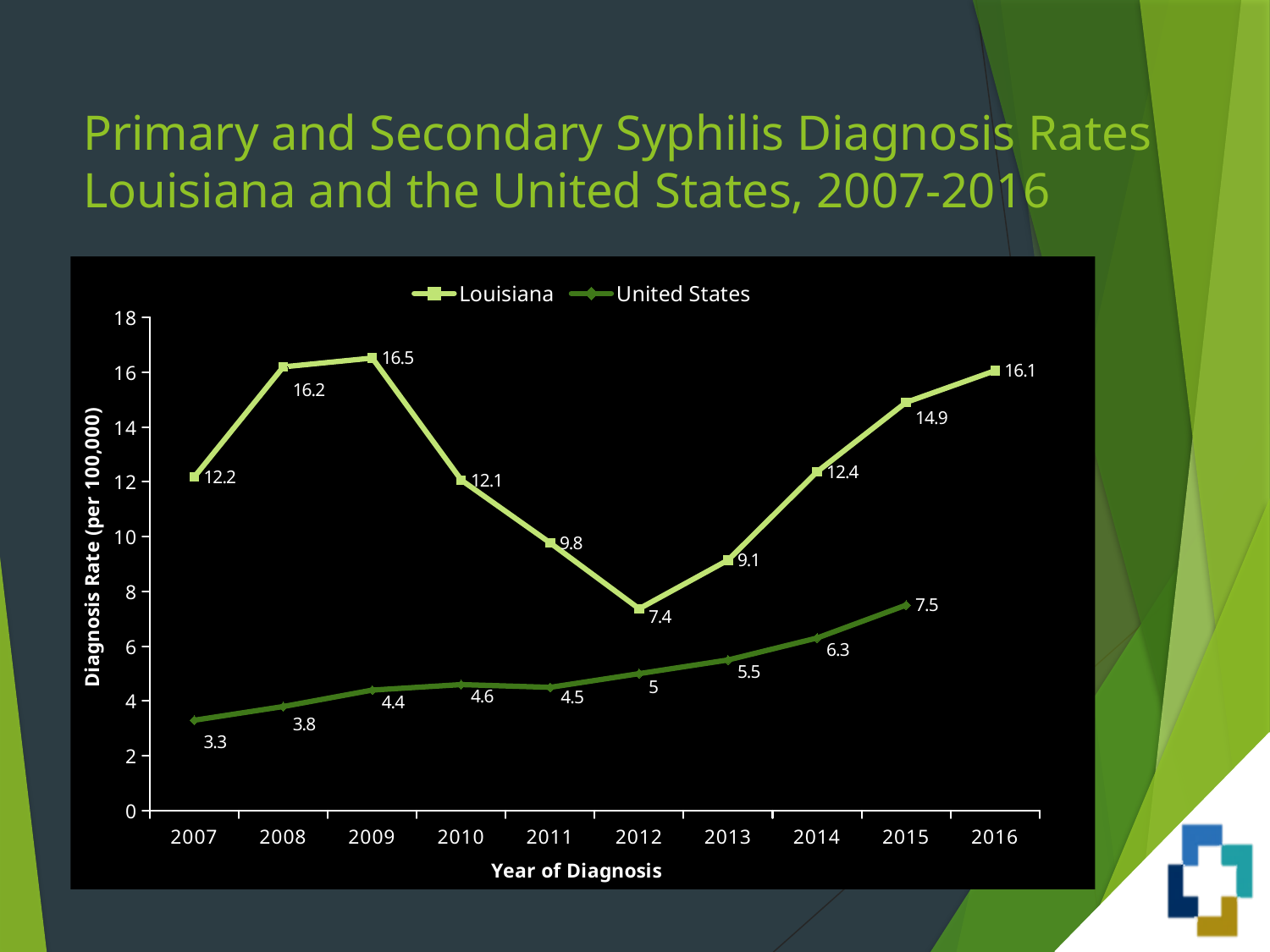
Which series has the higher diagnosis rate in 2013, Louisiana or United States? Louisiana What is the United States diagnosis rate in 2012? 5 What is the Louisiana diagnosis rate in 2009? 16.5 What is the difference between the Louisiana and United States diagnosis rates in 2015? 7.4 In which year is the Louisiana diagnosis rate highest? 2009 How many series does the legend list? 2 How many years are shown on the x axis? 10 Is the Louisiana diagnosis rate in 2014 greater or less than 10? greater What kind of chart is shown on the slide? Line chart In which year is the Louisiana diagnosis rate lowest? 2012 Does the United States diagnosis rate rise or fall from 2007 to 2015? Rise What is the Louisiana diagnosis rate in 2016? 16.1